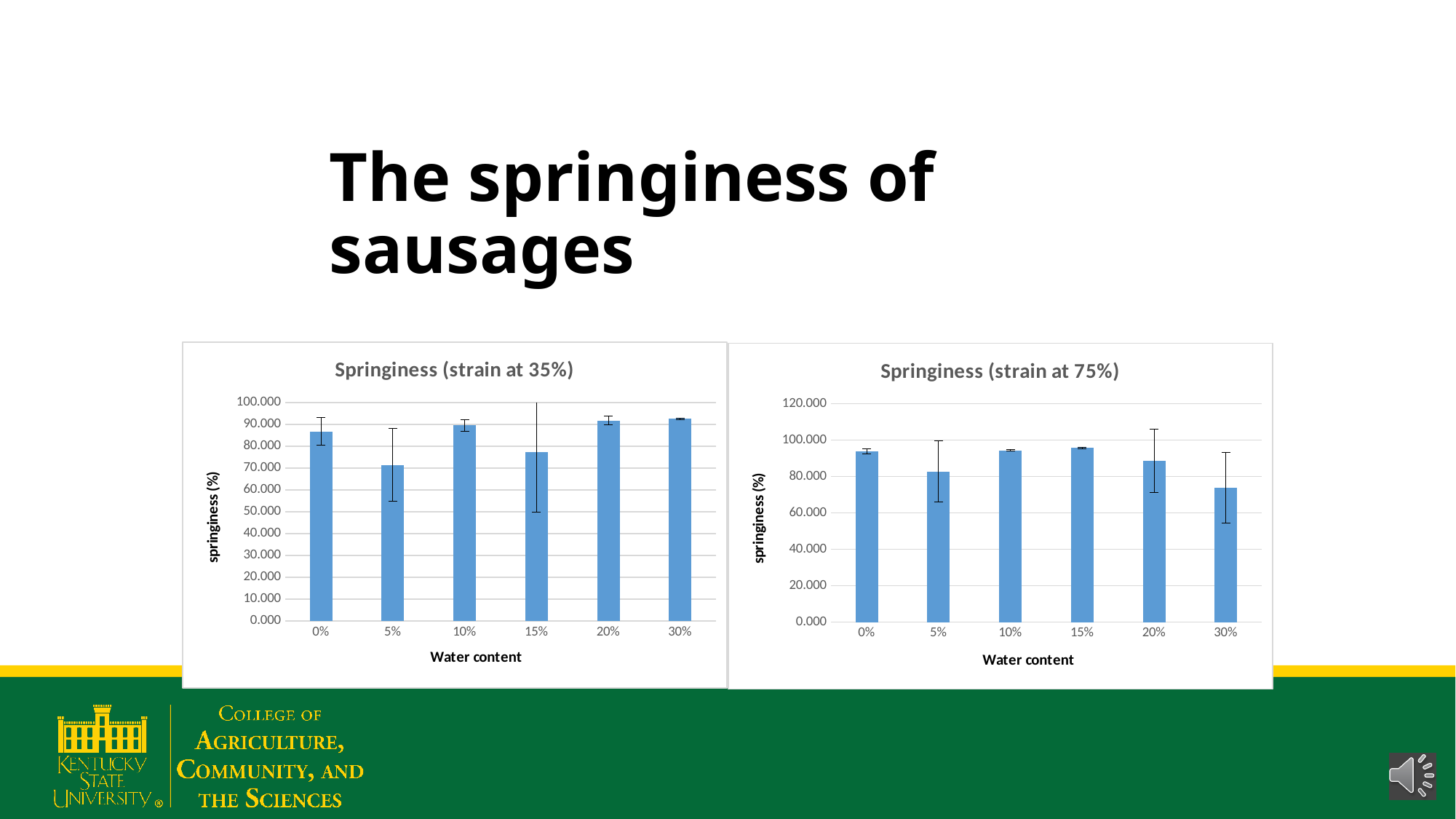
In the 'Springiness (strain at 75%)' chart, is the value for 30% water content greater or less than 80.000? less In the 'Springiness (strain at 35%)' chart, is the value for 5% water content greater or less than 80.000? less In the 'Springiness (strain at 75%)' chart, which water content has the lowest springiness? 30% In the 'Springiness (strain at 35%)' chart, which water content has the lowest springiness? 5% What is the y-axis label on the 'Springiness (strain at 75%)' chart? springiness (%) In the 'Springiness (strain at 75%)' chart, which is larger: the value for 15% or for 30% water content? 15% How many water content categories are shown in the 'Springiness (strain at 75%)' chart? 6 What type of chart is the 'Springiness (strain at 35%)' chart? bar chart In the 'Springiness (strain at 35%)' chart, is the value for 0% water content greater or less than 80.000? greater What is the x-axis label on the 'Springiness (strain at 35%)' chart? Water content In the 'Springiness (strain at 35%)' chart, which is larger: the value for 0% or for 5% water content? 0%